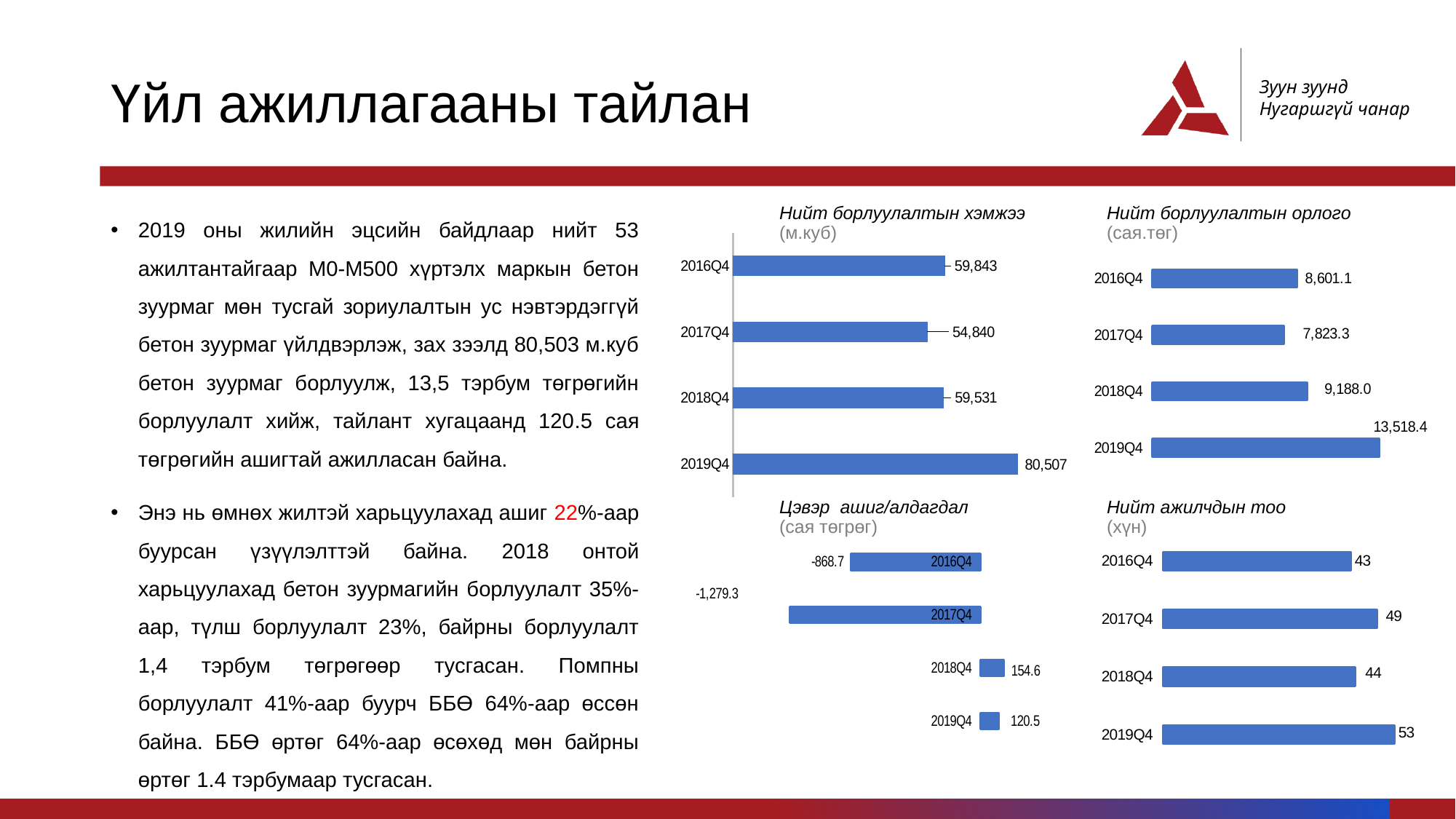
In the 'Нийт ажилчдын тоо' chart, what is the value for 2017Q4? 49 What unit is shown under the title of the 'Нийт ажилчдын тоо' chart? хүн In the 'Нийт борлуулалтын орлого' chart, what is the value for 2018Q4? 9,188.0 In the 'Цэвэр ашиг/алдагдал' chart, what is the value for 2017Q4? -1,279.3 In the 'Нийт борлуулалтын орлого' chart, which period has the highest value? 2019Q4 How many periods are shown in the 'Нийт ажилчдын тоо' chart? 4 In the 'Нийт борлуулалтын хэмжээ' chart, what is the value for 2019Q4? 80,507 In the 'Цэвэр ашиг/алдагдал' chart, which is larger, the value for 2018Q4 or 2019Q4? 2018Q4 In the 'Нийт борлуулалтын хэмжээ' chart, which period has the lowest value? 2017Q4 In the 'Нийт ажилчдын тоо' chart, what is the difference between the 2019Q4 and 2016Q4 values? 10 What type of chart is the 'Нийт борлуулалтын хэмжээ' chart? Bar chart In the 'Нийт борлуулалтын орлого' chart, what is the difference between the 2019Q4 and 2018Q4 values? 4,330.4